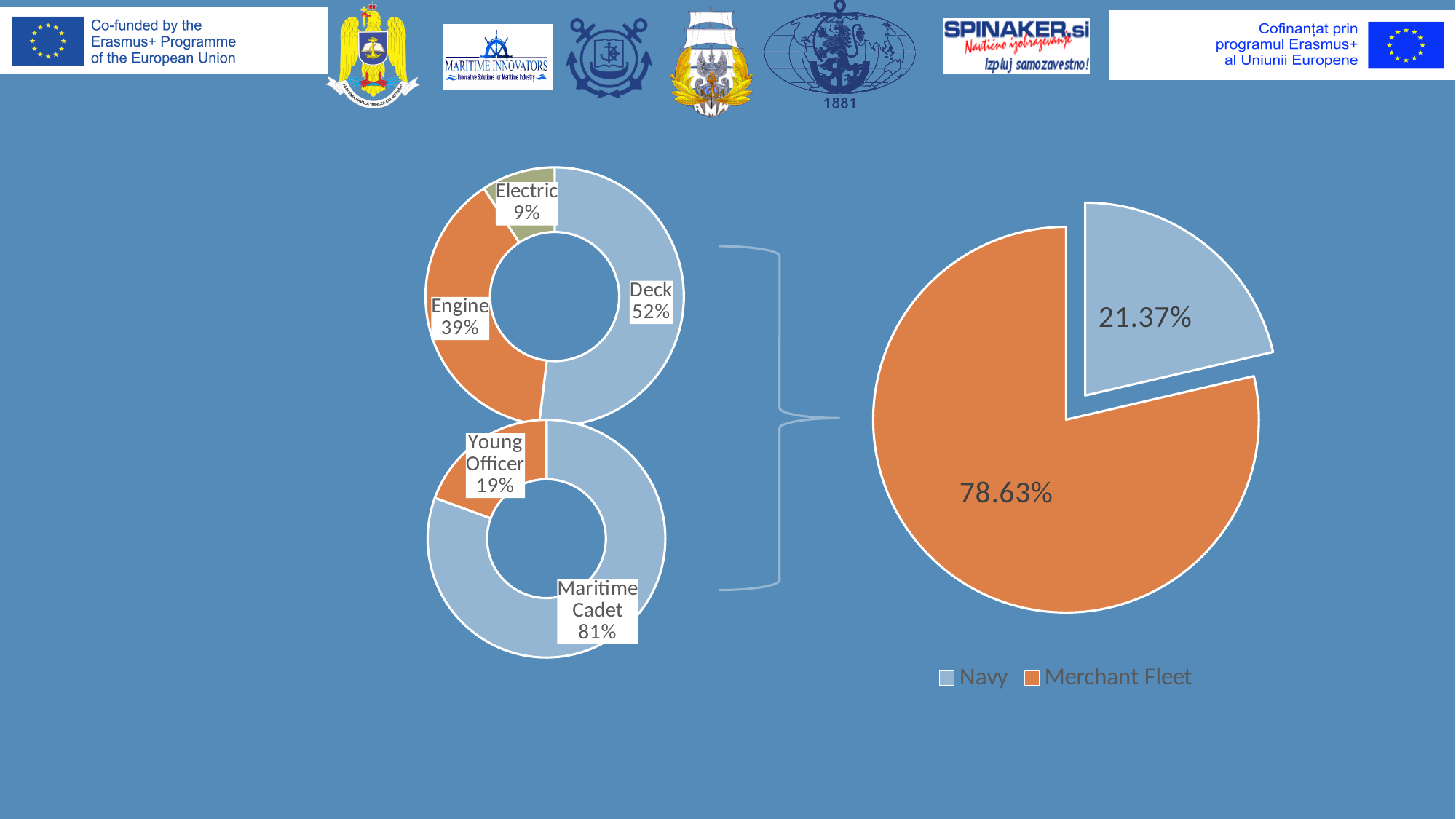
How many categories are shown in the upper doughnut chart on the left? 3 In the upper doughnut chart on the left, which category has the smallest share? Electric In the pie chart on the right, what is the value for Merchant Fleet? 78.63% In the pie chart on the right, what is the difference between the Merchant Fleet and Navy shares? 57.26% In the lower doughnut chart on the left, what is the value for Maritime Cadet? 81% What kind of chart is the chart on the right of the slide? Pie chart In the pie chart on the right, which category has the largest share? Merchant Fleet In the pie chart on the right, what is the value for Navy? 21.37% In the upper doughnut chart on the left, what is the value for Deck? 52% How many series does the legend of the pie chart on the right list? 2 In the upper doughnut chart on the left, what is the value for Engine? 39% In the lower doughnut chart on the left, what is the difference between Maritime Cadet and Young Officer? 62%